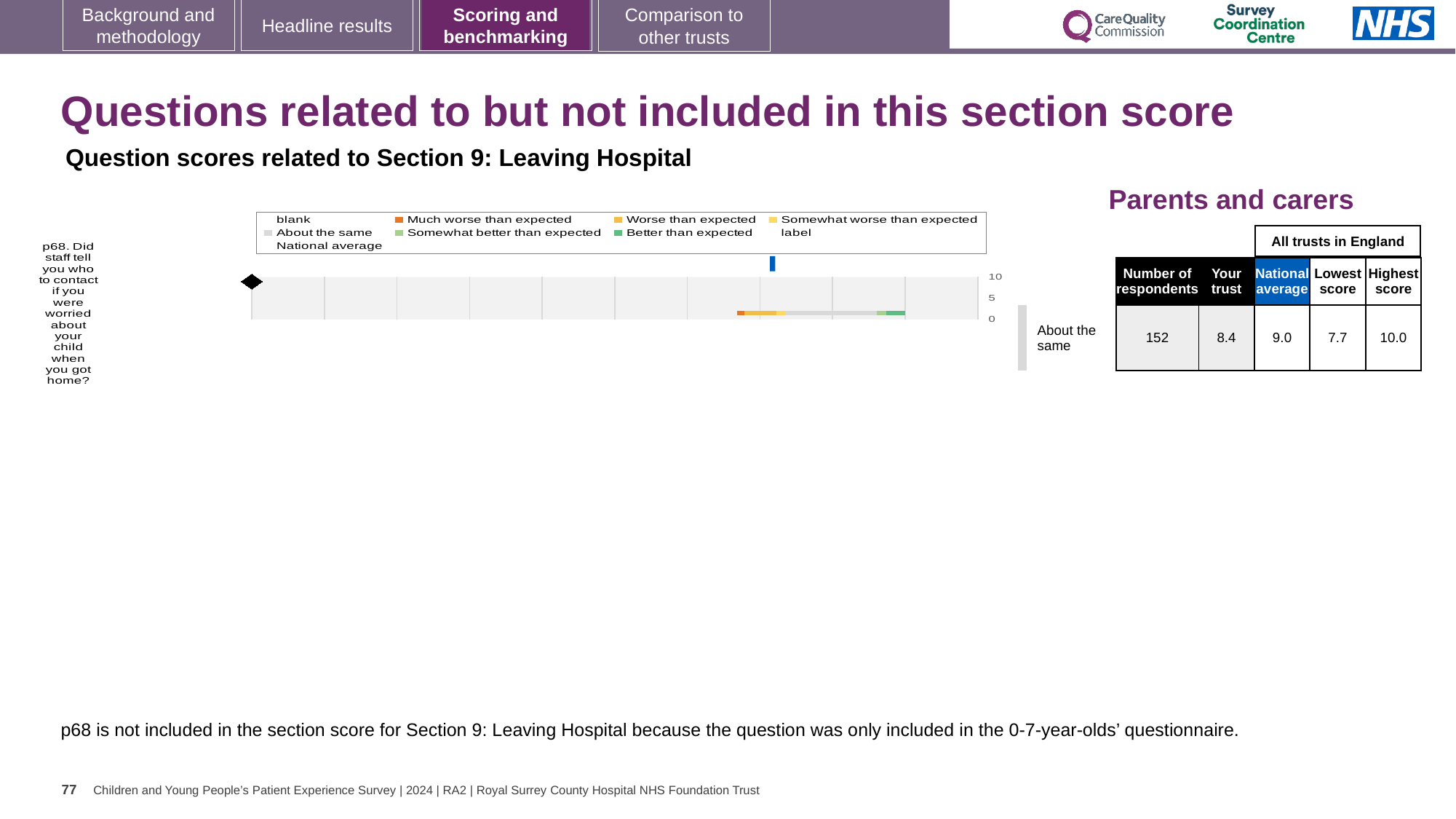
What is the difference between the highest score and the lowest score for p68 across all trusts in England? 2.3 Which is larger for p68, the 'Your trust' score or the national average? National average What does the blue marker in the chart represent, according to the legend? National average What is the difference between the national average and the 'Your trust' score for p68? 0.6 What is the national average score for p68? 9.0 What kind of chart is used to show the p68 question score? bar chart What benchmark category is given for p68 next to the chart? About the same What is the highest value shown on the chart's score axis? 10 What is the number of respondents for p68? 152 What is the 'Your trust' score for p68? 8.4 Which question number is plotted in the chart? p68 How many survey questions are plotted in the chart? 1